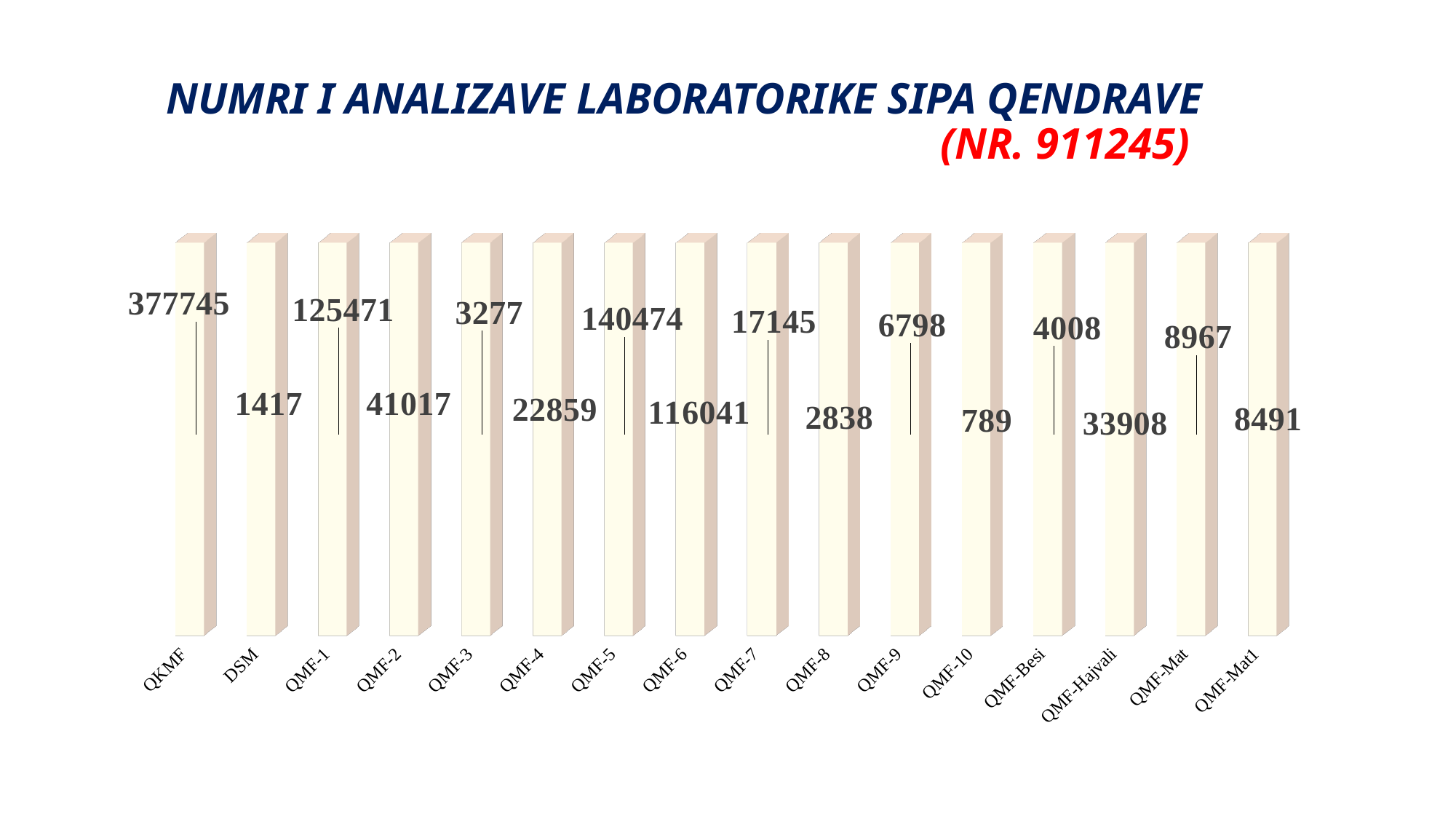
What is the difference between the values for QMF-5 and QMF-1? 15003 How many categories are shown on the chart? 16 What kind of chart is shown on the slide? Bar chart What total number is shown in red under the chart title? 911245 What is the value for QMF-6? 116041 Which category has the highest value? QKMF What is the value for QMF-Hajvali? 33908 What is the value for QMF-10? 789 What is the value for QKMF? 377745 Which is larger, the value for QMF-9 or the value for QMF-Besi? QMF-9 Which category has the lowest value? QMF-10 What is the difference between the values for QMF-Mat and QMF-Mat1? 476